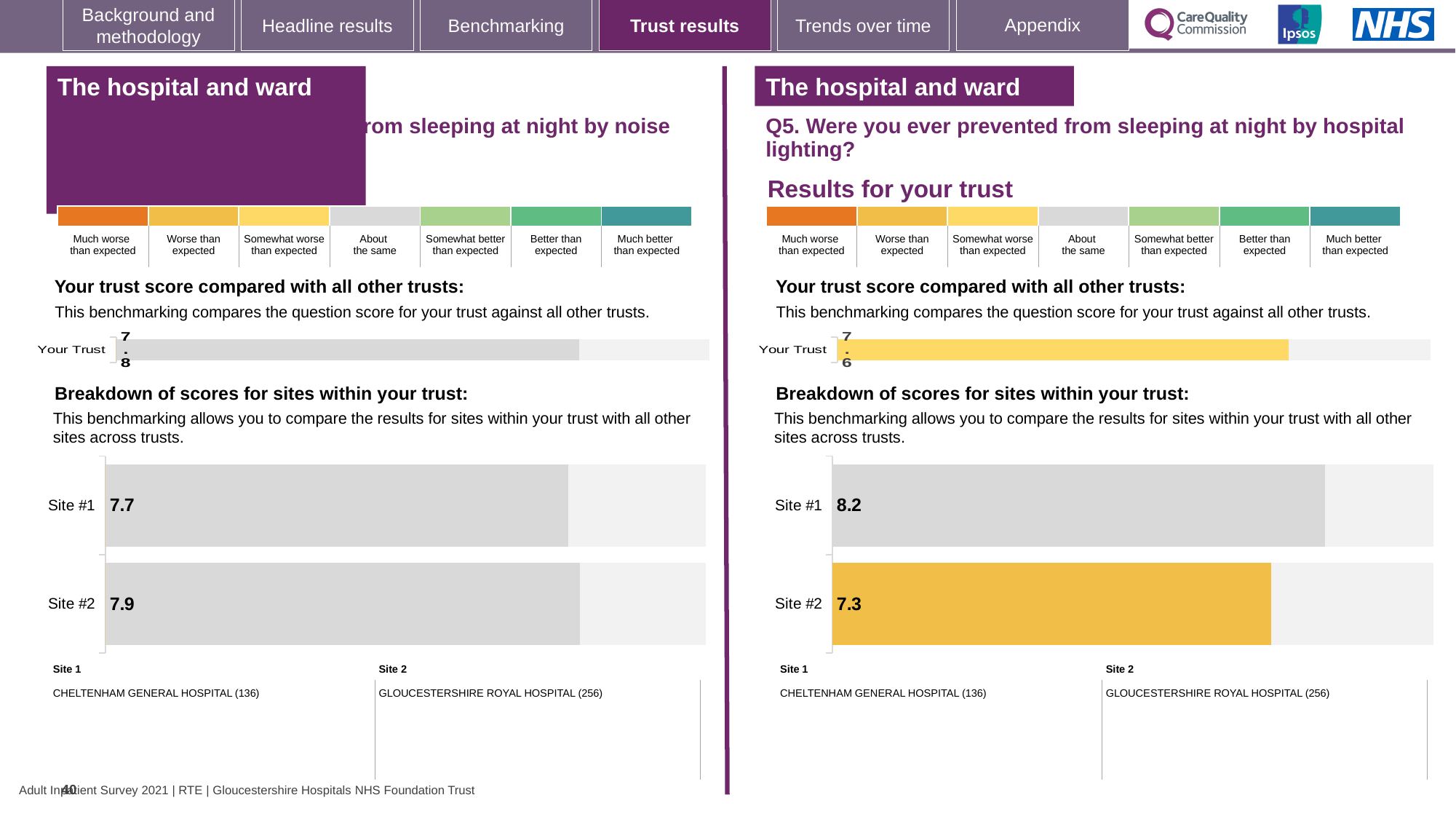
How many sites are shown in the right-hand 'Breakdown of scores for sites within your trust' chart (Q5, hospital lighting)? 2 In the left-hand 'Your trust score compared with all other trusts' chart (sleeping at night by noise), what is the score shown for Your Trust? 7.8 In the left-hand site breakdown chart (sleeping at night by noise), which site has the lower score? Site #1 In the left-hand 'Breakdown of scores for sites within your trust' chart (sleeping at night by noise), what is the score for Site #1? 7.7 In the right-hand 'Breakdown of scores for sites within your trust' chart (Q5, hospital lighting), what is the score for Site #1? 8.2 In the right-hand 'Your trust score compared with all other trusts' chart (Q5, hospital lighting), what is the score shown for Your Trust? 7.6 In the left-hand 'Breakdown of scores for sites within your trust' chart (sleeping at night by noise), what is the score for Site #2? 7.9 What type of chart is used for the site breakdown on the right-hand side of the slide (Q5, hospital lighting)? Bar chart In the right-hand site breakdown chart (Q5, hospital lighting), which site has the higher score? Site #1 In the right-hand site breakdown chart (Q5, hospital lighting), what is the difference between the Site #1 and Site #2 scores? 0.9 In the right-hand 'Breakdown of scores for sites within your trust' chart (Q5, hospital lighting), what is the score for Site #2? 7.3 In the left-hand site breakdown chart (sleeping at night by noise), what is the difference between the Site #2 and Site #1 scores? 0.2